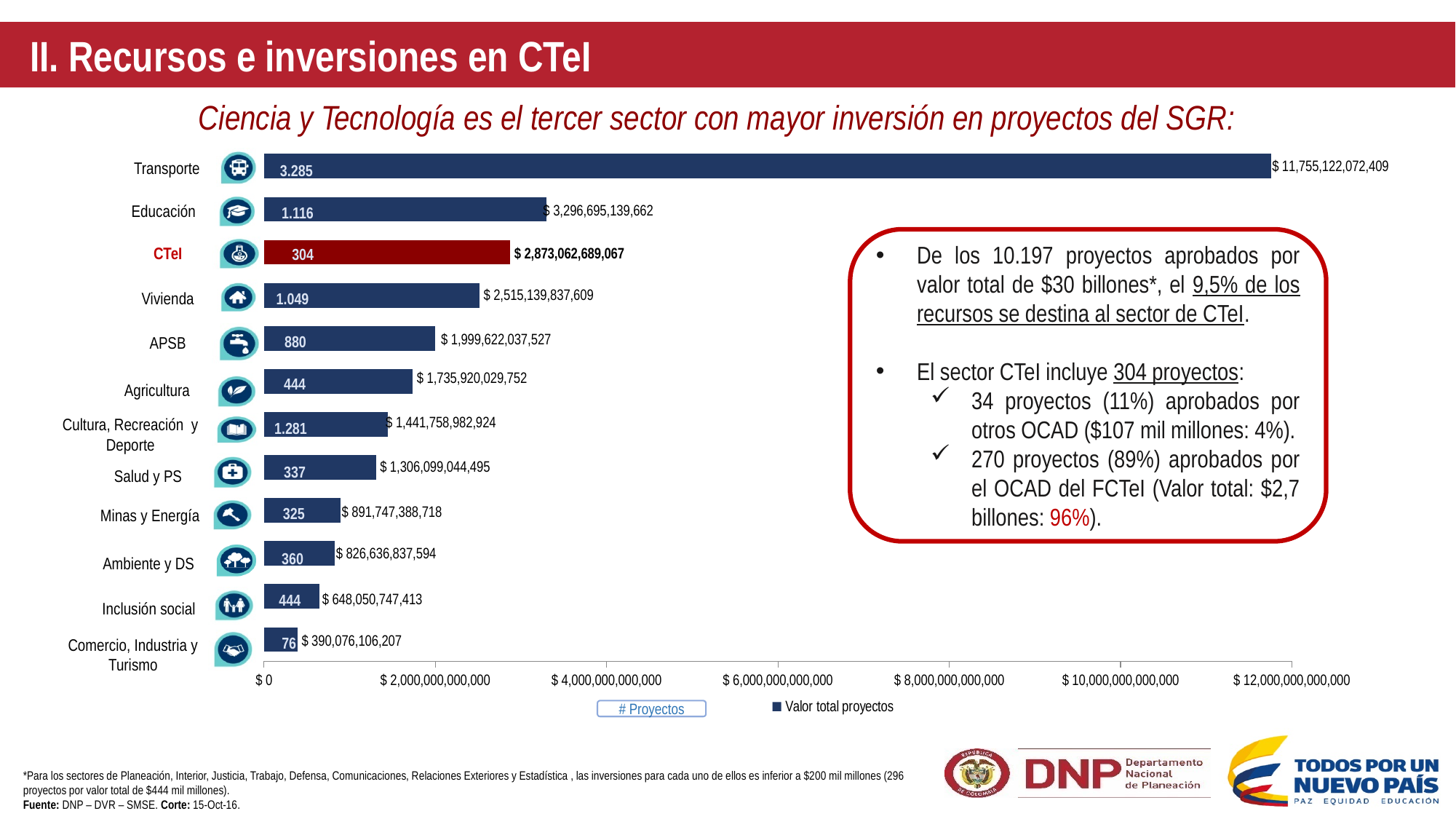
How many entries does the chart legend list? 2 How many sectors are shown in the chart? 12 What is the total project value for Transporte? $ 11,755,122,072,409 Which sector has the highest total project value? Transporte Which bar in the chart is highlighted in a different colour (red) from the others? CTeI Which sector has the lowest total project value? Comercio, Industria y Turismo Is the total project value for Transporte greater or less than $ 10,000,000,000,000? greater What is the difference in total project value between Educación and CTeI? $ 423,632,450,595 What type of chart is shown on the slide? Bar chart What is the total project value for the CTeI sector? $ 2,873,062,689,067 How many projects does the Educación bar show? 1.116 Which has a larger total project value, Vivienda or APSB? Vivienda